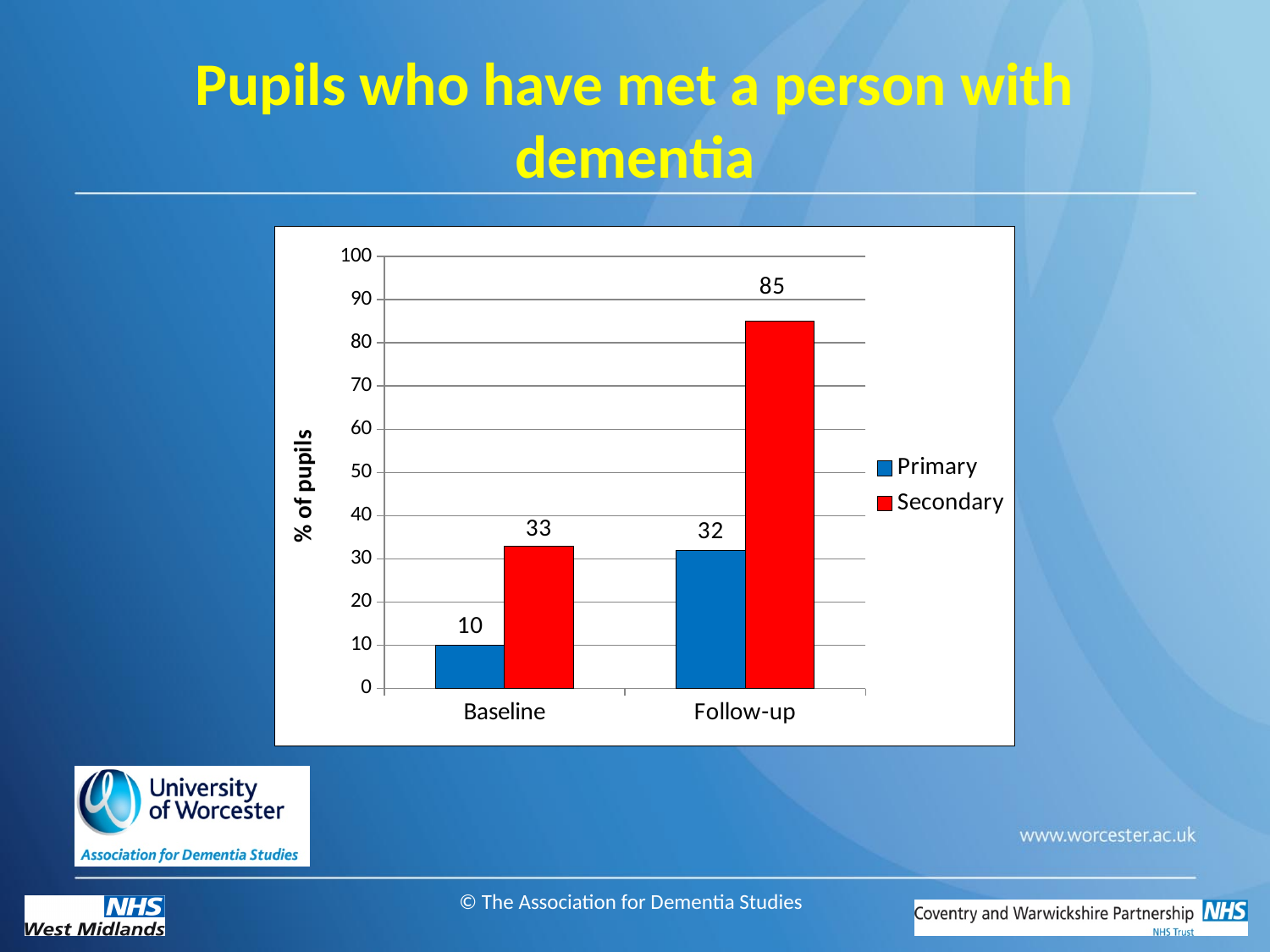
What is the difference between the Secondary values at Follow-up and Baseline? 52 What is the value for Primary at Baseline? 10 What is the value for Secondary at Follow-up? 85 Which bar has the lowest value in the chart? Primary at Baseline Which is larger at Follow-up, Primary or Secondary? Secondary What is the difference between the Primary values at Follow-up and Baseline? 22 What is the value for Secondary at Baseline? 33 How many series does the legend list? 2 What is the value for Primary at Follow-up? 32 Which bar has the highest value in the chart? Secondary at Follow-up What is the label of the y axis? % of pupils What kind of chart is shown on the slide? Bar chart